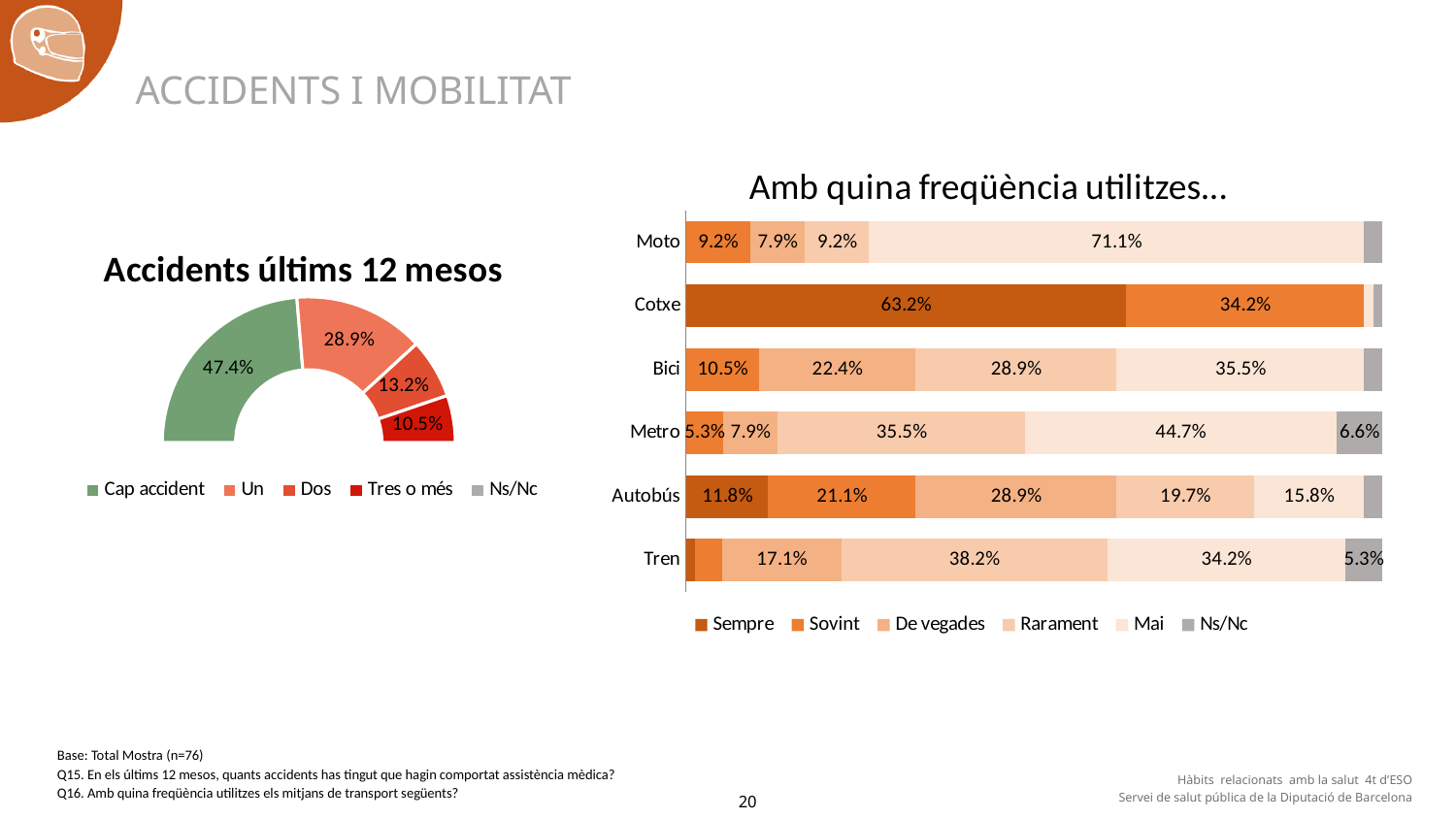
What kind of chart is 'Amb quina freqüència utilitzes…'? stacked bar chart How many transport categories are shown in the 'Amb quina freqüència utilitzes…' chart? 6 In the 'Accidents últims 12 mesos' chart, which category has the largest slice? Cap accident In the 'Accidents últims 12 mesos' chart, what share is 'Cap accident'? 47.4% What kind of chart is 'Accidents últims 12 mesos'? doughnut chart In the 'Accidents últims 12 mesos' chart, what is the value for 'Un'? 28.9% In the 'Accidents últims 12 mesos' chart, what is the difference between 'Un' and 'Dos'? 15.7 percentage points In the 'Amb quina freqüència utilitzes…' chart, what is the 'Sempre' value for Cotxe? 63.2% In the 'Amb quina freqüència utilitzes…' chart, what is the 'Ns/Nc' value for Metro? 6.6% How many entries does the legend of the 'Accidents últims 12 mesos' chart list? 5 In the 'Amb quina freqüència utilitzes…' chart, what is the 'Mai' value for Moto? 71.1% How many series does the legend of the 'Amb quina freqüència utilitzes…' chart list? 6